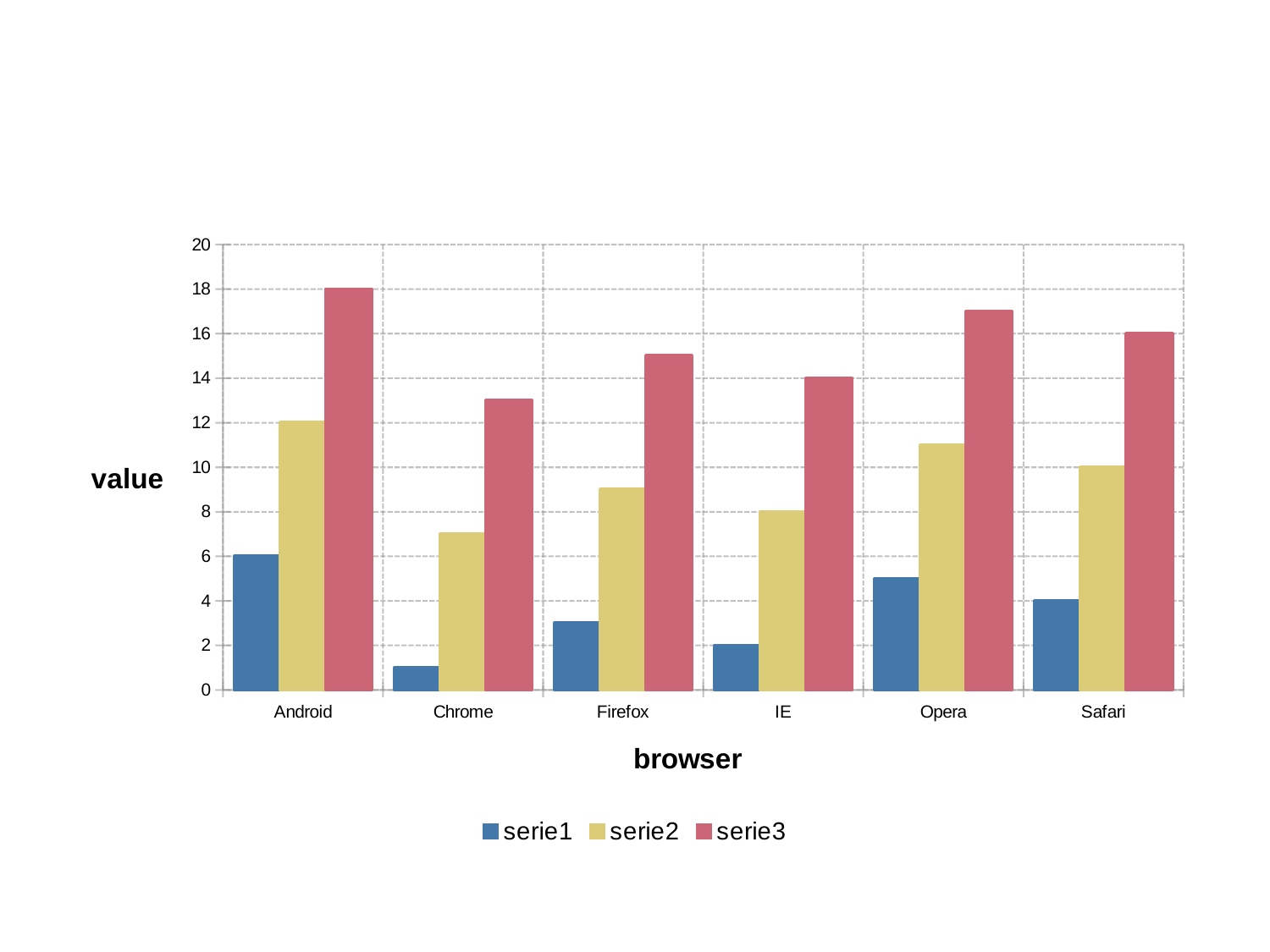
How many series does the legend list? 3 How many browser categories are shown on the x axis? 6 Which browser has the highest serie3 value? Android What is the value of serie3 for Android? 18 What is the value of serie1 for IE? 2 Which browser has the lowest serie1 value? Chrome Is the value of serie2 for Opera greater or less than 10? greater What kind of chart is shown on the slide? bar chart What is the value of serie2 for Safari? 10 What is the difference between serie3 and serie1 for Android? 12 Which is larger for Firefox: serie2 or serie3? serie3 What is the label of the y axis? value